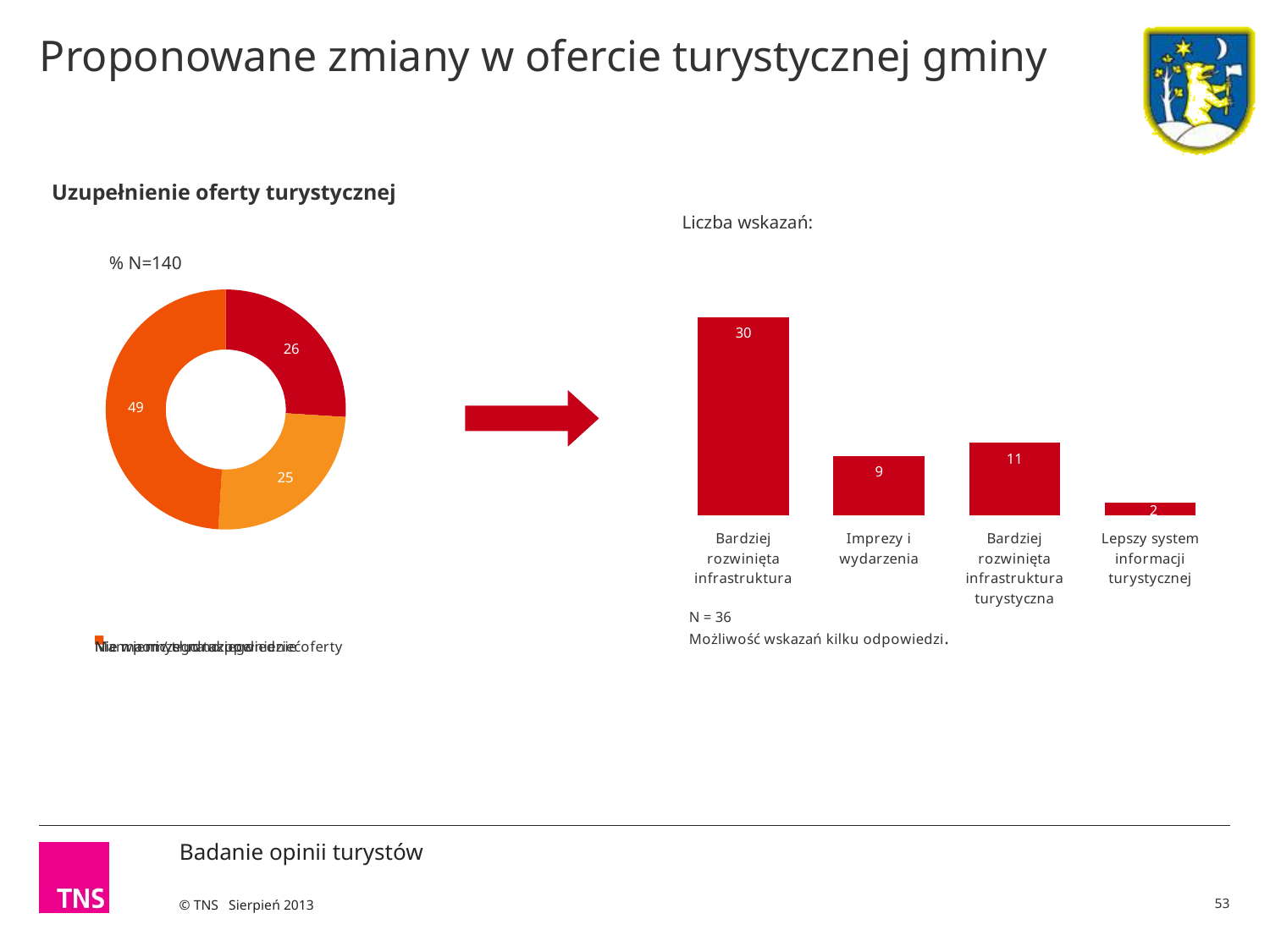
What is the sample size (N) stated for the bar chart on the right? N = 36 How many slices does the donut chart on the left have? 3 On the donut chart on the left, what is the largest value shown? 49 What kind of chart is shown on the right side of the slide? Bar chart On the bar chart on the right, what is the value for 'Lepszy system informacji turystycznej'? 2 On the bar chart on the right, which category has the highest number of indications? Bardziej rozwinięta infrastruktura On the bar chart on the right, what is the difference between 'Bardziej rozwinięta infrastruktura' and 'Bardziej rozwinięta infrastruktura turystyczna'? 19 On the bar chart on the right, how many indications are shown for 'Bardziej rozwinięta infrastruktura'? 30 On the bar chart on the right, which is larger: 'Imprezy i wydarzenia' or 'Bardziej rozwinięta infrastruktura turystyczna'? Bardziej rozwinięta infrastruktura turystyczna On the bar chart on the right, which category has the lowest number of indications? Lepszy system informacji turystycznej How many categories are shown on the bar chart on the right? 4 On the bar chart on the right, what is the value for 'Imprezy i wydarzenia'? 9